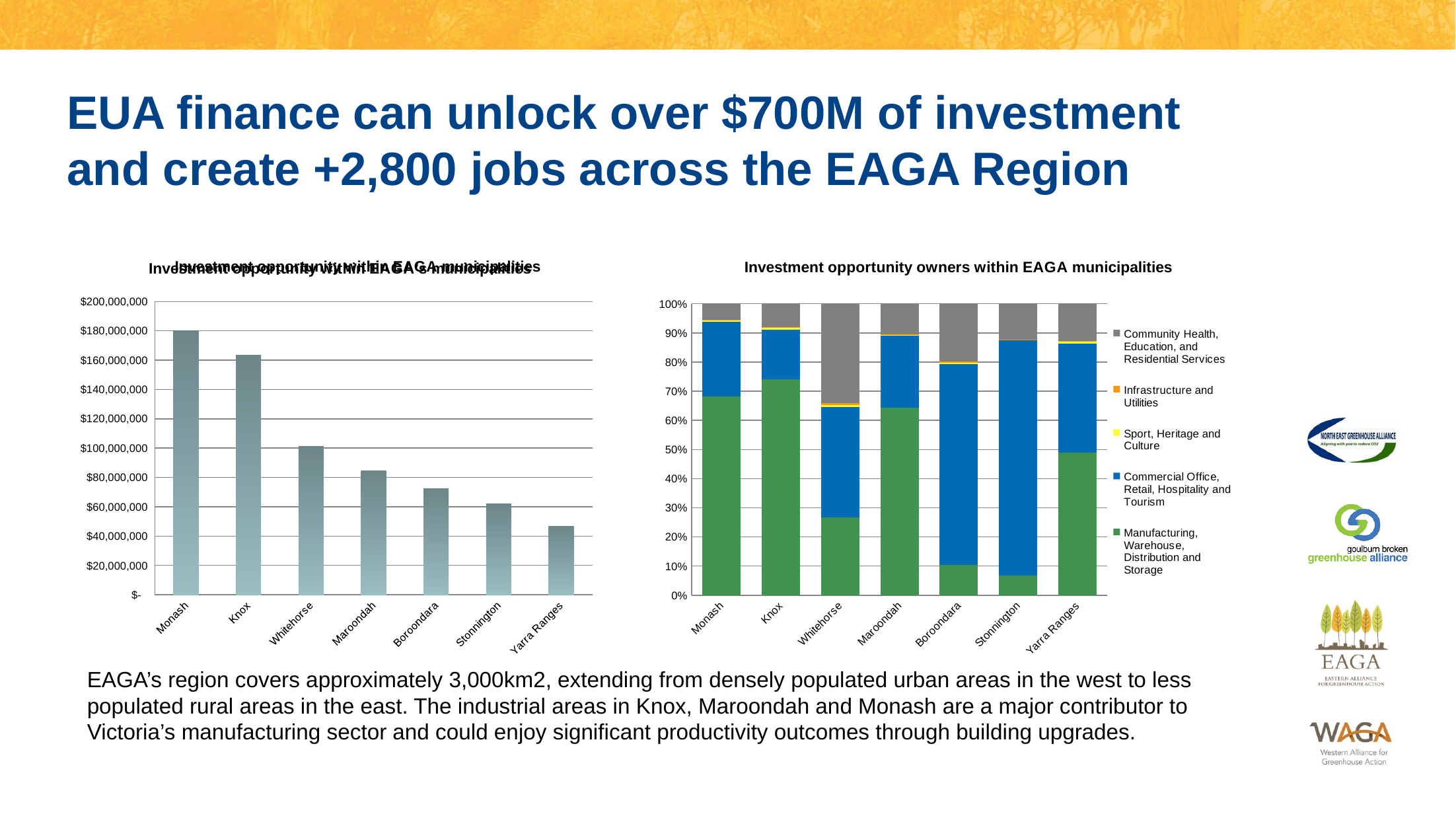
On the left chart, Investment opportunity within EAGA municipalities, is the value for Yarra Ranges greater or less than $60,000,000? less What kind of chart is the right chart, Investment opportunity owners within EAGA municipalities? stacked bar chart On the right chart, Investment opportunity owners within EAGA municipalities, how many series does the legend list? 5 On the left chart, Investment opportunity within EAGA municipalities, is the value for Knox greater or less than $140,000,000? greater On the left chart, Investment opportunity within EAGA municipalities, is the value for Maroondah greater or less than $100,000,000? less On the right chart, Investment opportunity owners within EAGA municipalities, which municipality has the largest share for Manufacturing, Warehouse, Distribution and Storage? Knox On the left chart, Investment opportunity within EAGA municipalities, which is larger: the value for Whitehorse or the value for Boroondara? Whitehorse On the left chart, Investment opportunity within EAGA municipalities, which municipality has the lowest investment opportunity? Yarra Ranges On the left chart, Investment opportunity within EAGA municipalities, how many municipalities are shown? 7 On the right chart, Investment opportunity owners within EAGA municipalities, which colour represents Community Health, Education, and Residential Services? grey On the left chart, Investment opportunity within EAGA municipalities, do the values rise or fall from left to right along the x axis? fall On the left chart, Investment opportunity within EAGA municipalities, which municipality has the highest investment opportunity? Monash